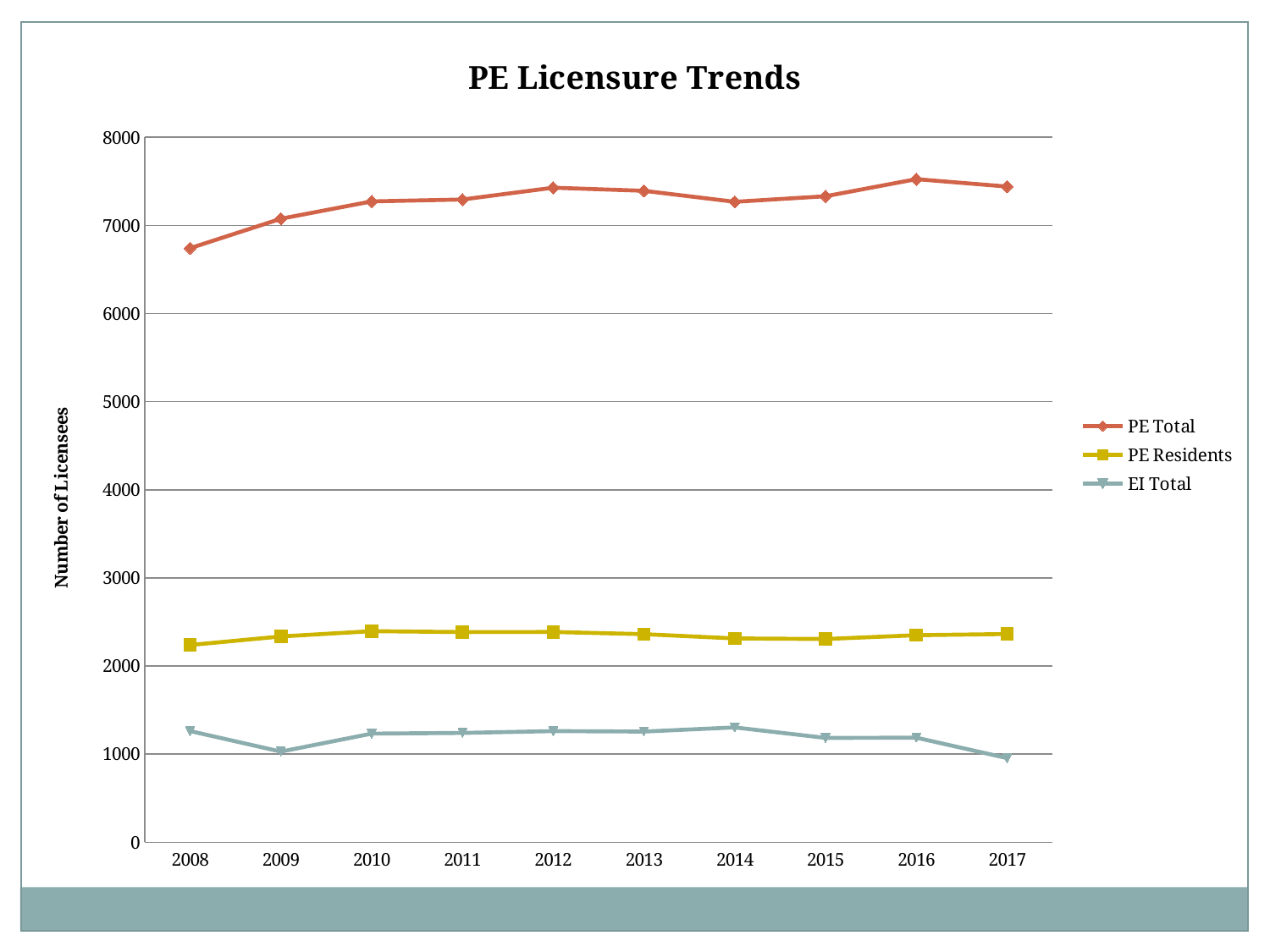
In which year is the PE Residents value lowest? 2008 What type of chart is shown on the slide? Line chart How many series does the legend list? 3 What is the title of the chart? PE Licensure Trends Does the PE Total series rise or fall from 2008 to 2010? rise Is the PE Total value for 2008 greater or less than 7000? less Which series has the higher value in 2012, PE Residents or EI Total? PE Residents In which year is the PE Total value highest? 2016 How many years are plotted along the x axis? 10 What is the label of the y axis? Number of Licensees In which year is the PE Total value lowest? 2008